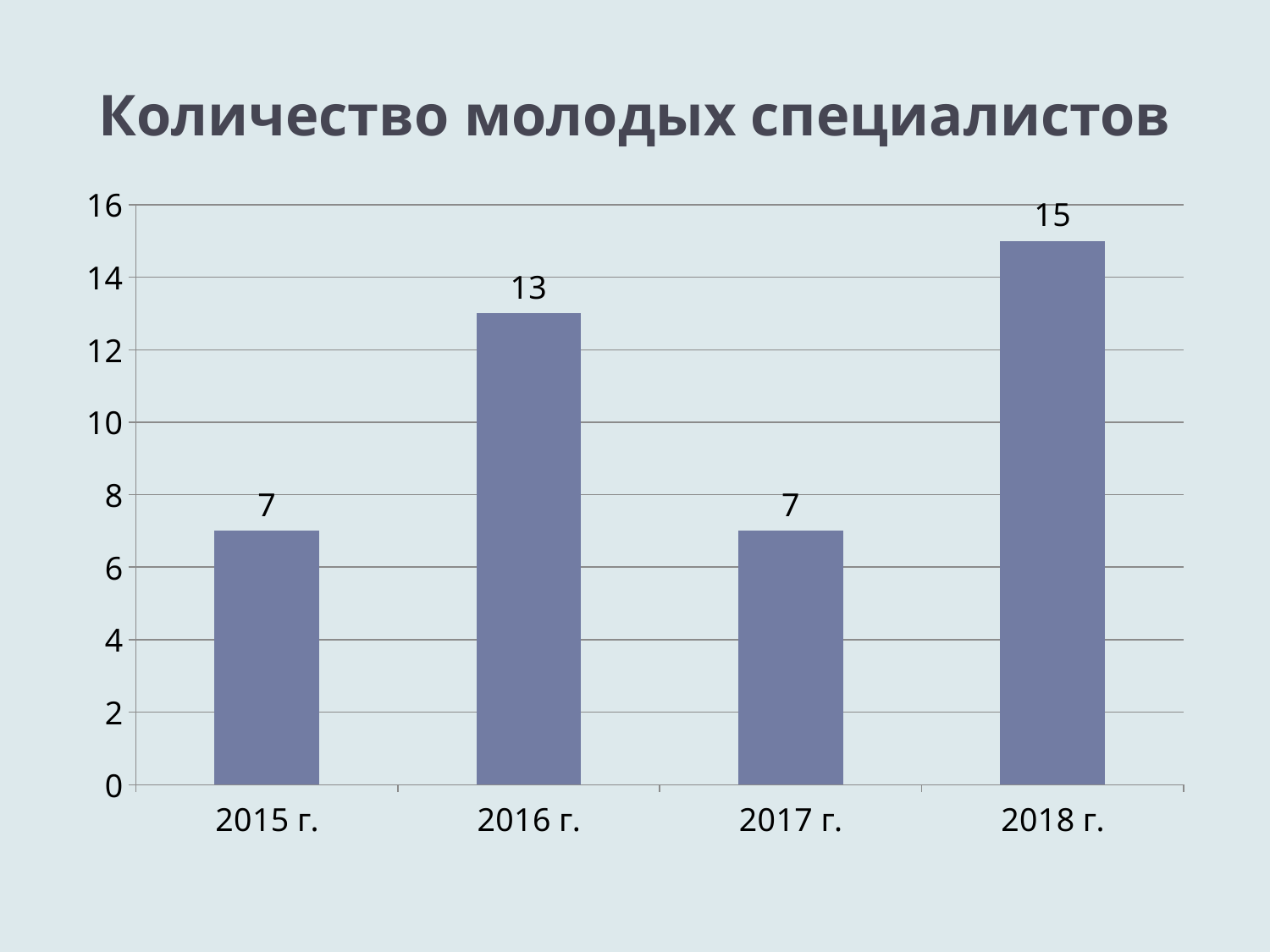
What is the difference between the values for 2018 г. and 2016 г.? 2 What is the value for 2015 г.? 7 What is the title of the chart? Количество молодых специалистов What is the difference between the values for 2016 г. and 2017 г.? 6 Which is larger, the value for 2016 г. or the value for 2017 г.? 2016 г. Is the value for 2018 г. greater or less than 14? greater Does the value rise or fall from 2017 г. to 2018 г.? rise How many years are shown on the x axis? 4 What is the value for 2018 г.? 15 Which year has the highest value? 2018 г. What is the value for 2016 г.? 13 What kind of chart is shown on the slide? bar chart